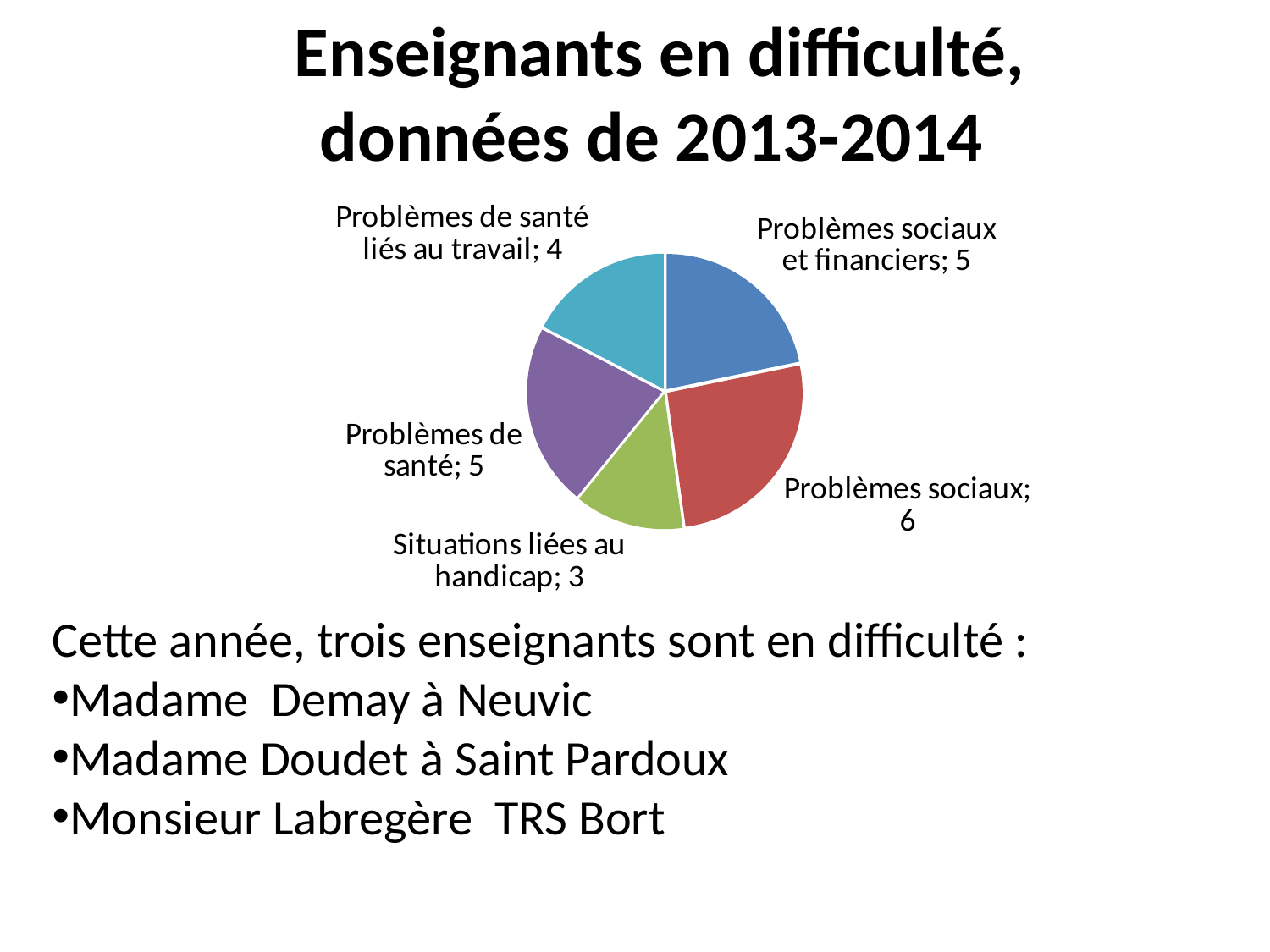
Which is larger: the value for "Problèmes sociaux" or the value for "Problèmes de santé liés au travail"? Problèmes sociaux What is the total of all the values shown in the pie chart? 23 What is the title of the slide containing the pie chart? Enseignants en difficulté, données de 2013-2014 What is the value for "Problèmes sociaux et financiers"? 5 What kind of chart is shown on the slide? Pie chart Which category has the largest slice of the pie? Problèmes sociaux What is the value for "Problèmes sociaux"? 6 Which category has the smallest slice of the pie? Situations liées au handicap What is the value for "Problèmes de santé liés au travail"? 4 What is the value for "Situations liées au handicap"? 3 What is the difference between the values for "Problèmes sociaux" and "Situations liées au handicap"? 3 How many categories does the pie chart show? 5